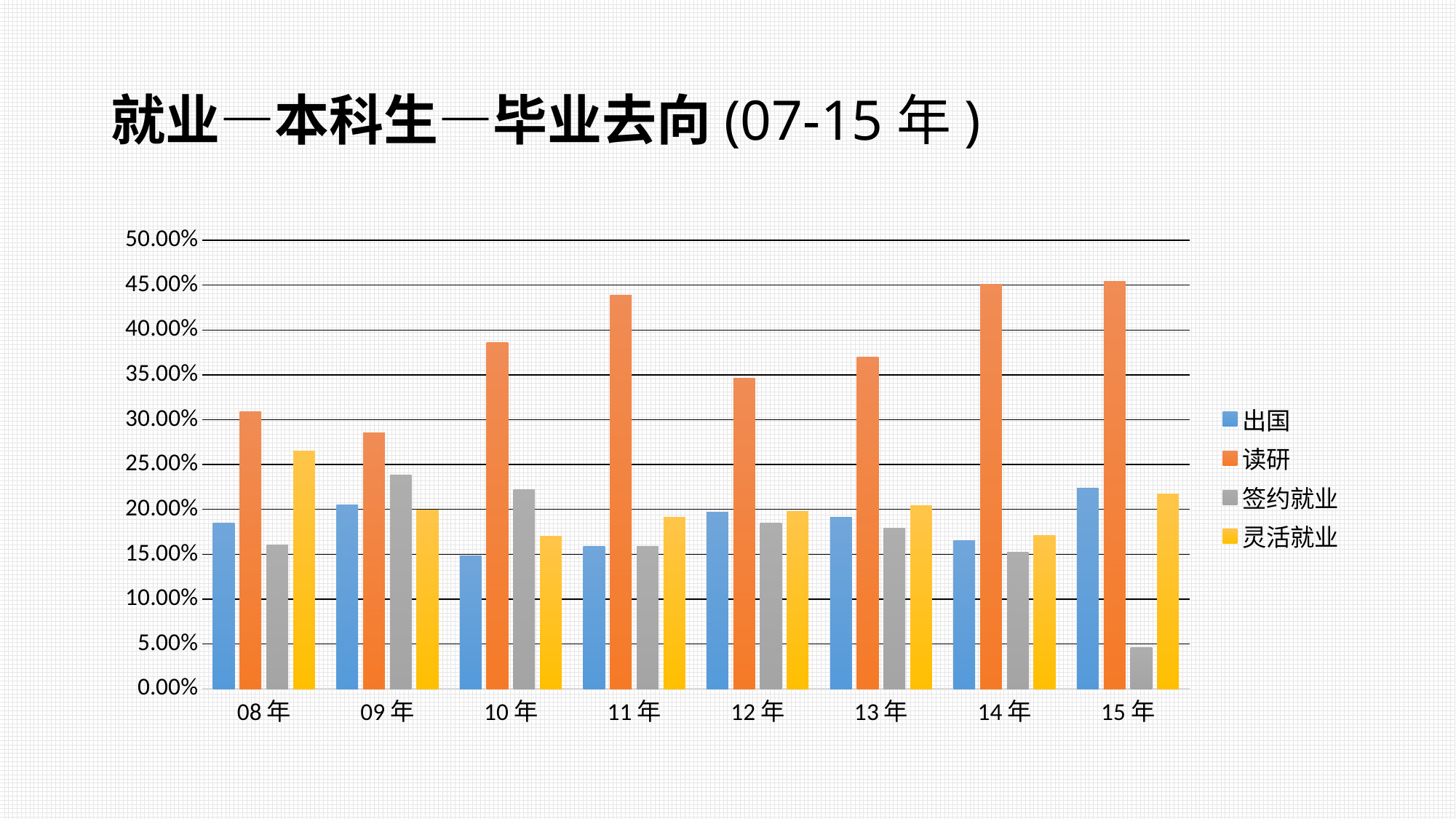
In 09年, which is larger: 签约就业 or 出国? 签约就业 Is the value for 签约就业 in 15年 greater or less than 10.00%? less What kind of chart is shown on the slide? bar chart In which year is the value for 读研 the lowest? 09年 Is the value for 灵活就业 in 08年 greater or less than 25.00%? greater How many series does the legend list? 4 Does the value for 读研 rise or fall from 12年 to 15年? rise Is the value for 读研 in 11年 greater or less than 40.00%? greater In 08年, which is larger: 读研 or 灵活就业? 读研 How many year categories are shown on the x axis? 8 In which year is the value for 签约就业 the lowest? 15年